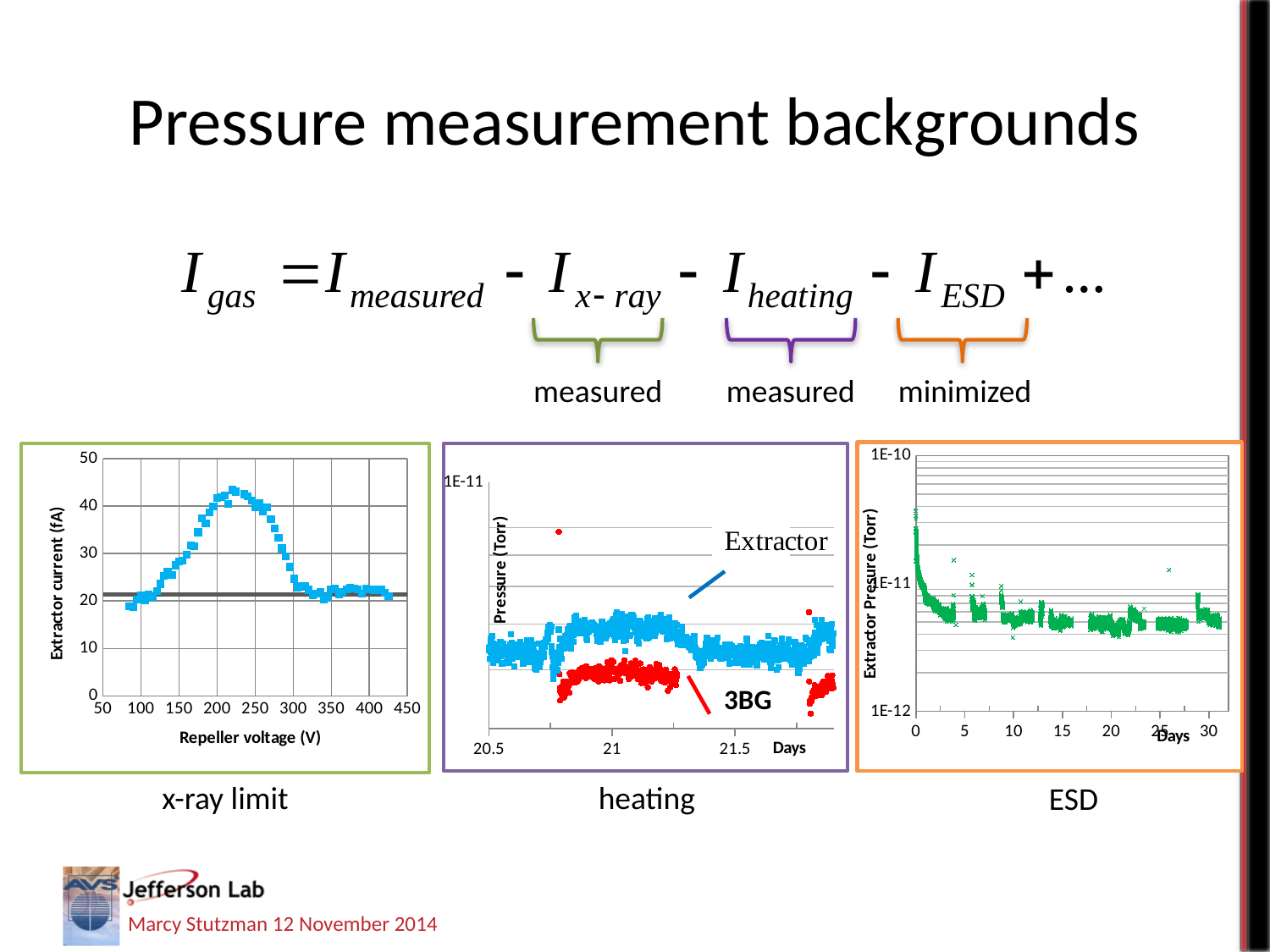
In the x-ray limit chart, is the extractor current at a repeller voltage of 200 V greater or less than 30 fA? greater In the x-ray limit chart, what is the label of the y axis? Extractor current (fA) In the ESD chart on the right, is the extractor pressure at day 20 greater or less than 1E-11 Torr? less In the x-ray limit chart, what is the highest value shown on the y axis? 50 In the x-ray limit chart, does the extractor current rise or fall as the repeller voltage increases from 250 V to 300 V? fall In the heating chart in the middle, how many data series are plotted? 2 What kind of chart is the x-ray limit chart on the left? scatter chart In the x-ray limit chart, is the extractor current at a repeller voltage of 400 V greater or less than 30 fA? less In the heating chart, which series shows the higher pressure, Extractor or 3BG? Extractor In the ESD chart on the right, does the extractor pressure rise or fall over the first 5 days? fall In the x-ray limit chart, what is the label of the x axis? Repeller voltage (V) In the x-ray limit chart, does the extractor current rise or fall as the repeller voltage increases from 100 V to 200 V? rise